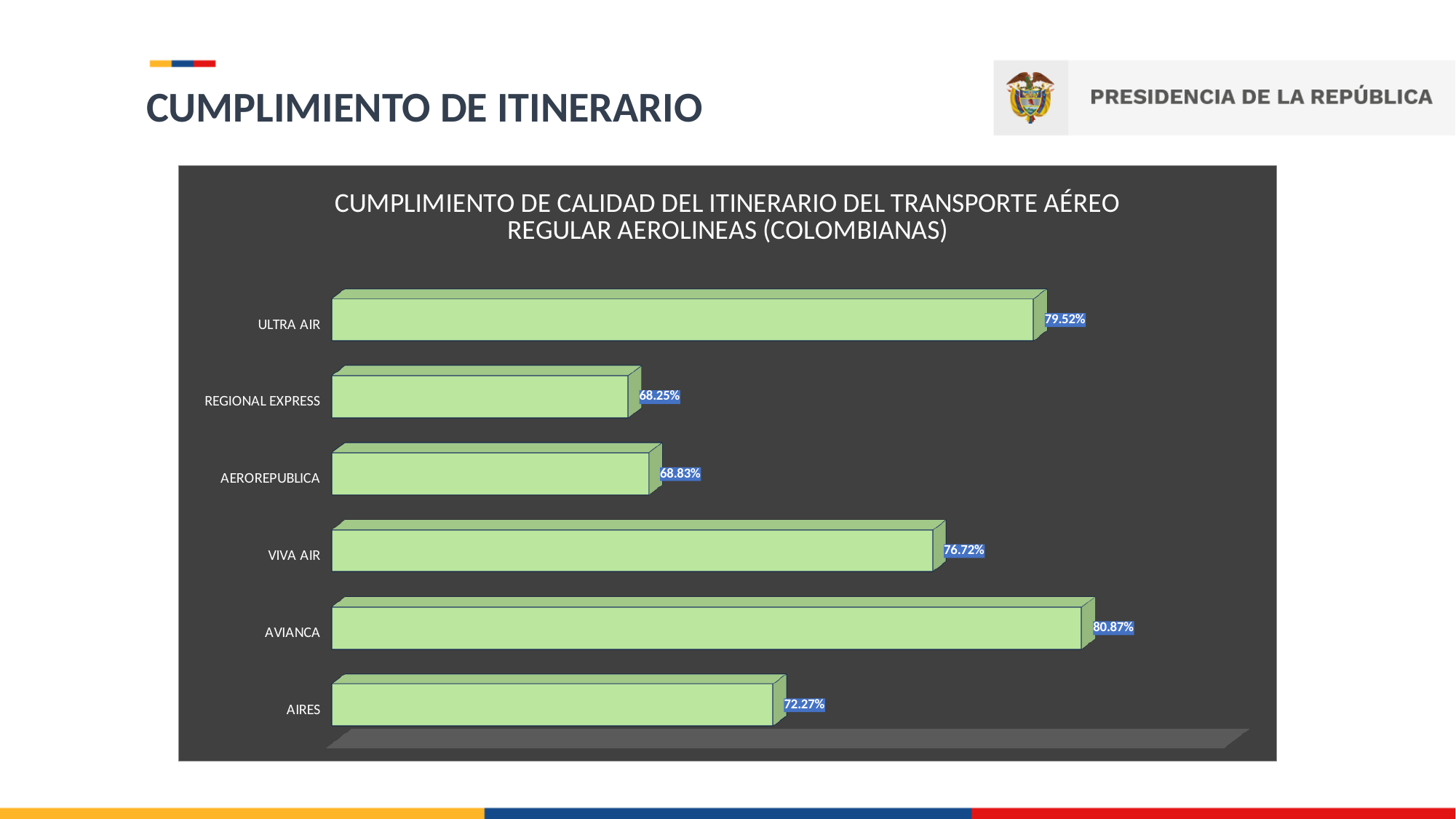
What kind of chart is shown on the slide? Bar chart What is the title of the chart? CUMPLIMIENTO DE CALIDAD DEL ITINERARIO DEL TRANSPORTE AÉREO REGULAR AEROLINEAS (COLOMBIANAS) What is the value for REGIONAL EXPRESS? 68.25% What is the difference between the values for ULTRA AIR and AIRES? 7.25% How many airlines are shown in the chart? 6 Which is larger, the value for VIVA AIR or the value for AEROREPUBLICA? VIVA AIR What is the value for AVIANCA? 80.87% Which airline has the highest value? AVIANCA What is the value for ULTRA AIR? 79.52% What is the value for AIRES? 72.27% Which airline has the lowest value? REGIONAL EXPRESS What is the difference between the values for AVIANCA and VIVA AIR? 4.15%